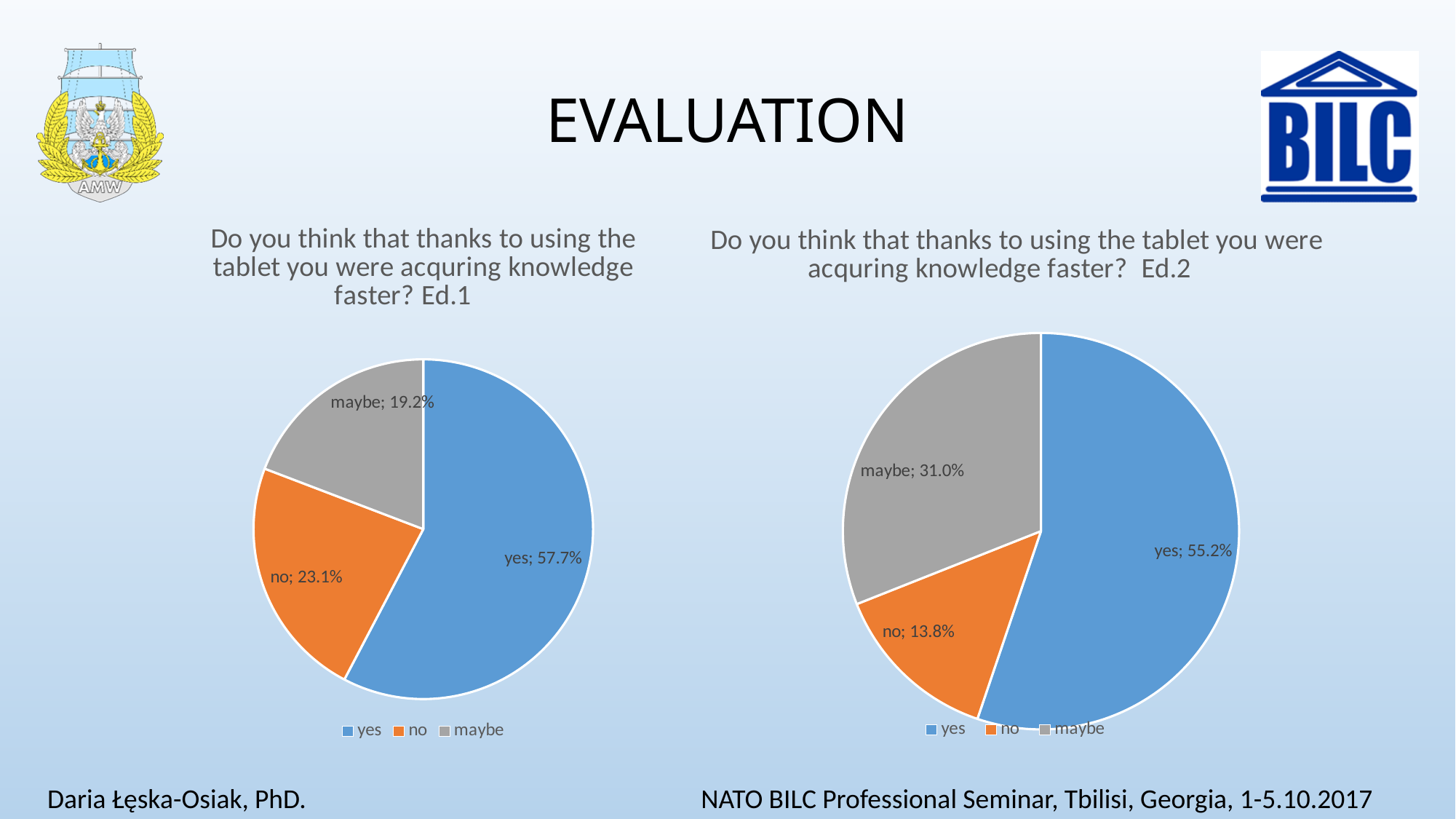
In the Ed.1 pie chart on the left, which answer has the smallest share? maybe Is the "maybe" share larger in the Ed.1 chart on the left or the Ed.2 chart on the right? Ed.2 What type of chart is used on the right for Ed.2? Pie chart How many categories does the Ed.1 pie chart on the left show? 3 In the Ed.2 pie chart on the right, what percentage answered "maybe"? 31.0% In the Ed.1 pie chart on the left, what percentage answered "yes"? 57.7% In the Ed.2 pie chart on the right, what is the difference between the "maybe" and "no" shares? 17.2% In the Ed.1 pie chart on the left, what percentage answered "no"? 23.1% In the Ed.2 pie chart on the right, which answer has the largest share? yes In the Ed.2 pie chart on the right, what percentage answered "no"? 13.8% In the Ed.1 pie chart on the left, what is the difference between the "yes" and "no" shares? 34.6% In the Ed.2 pie chart on the right, which answer has the smallest share? no